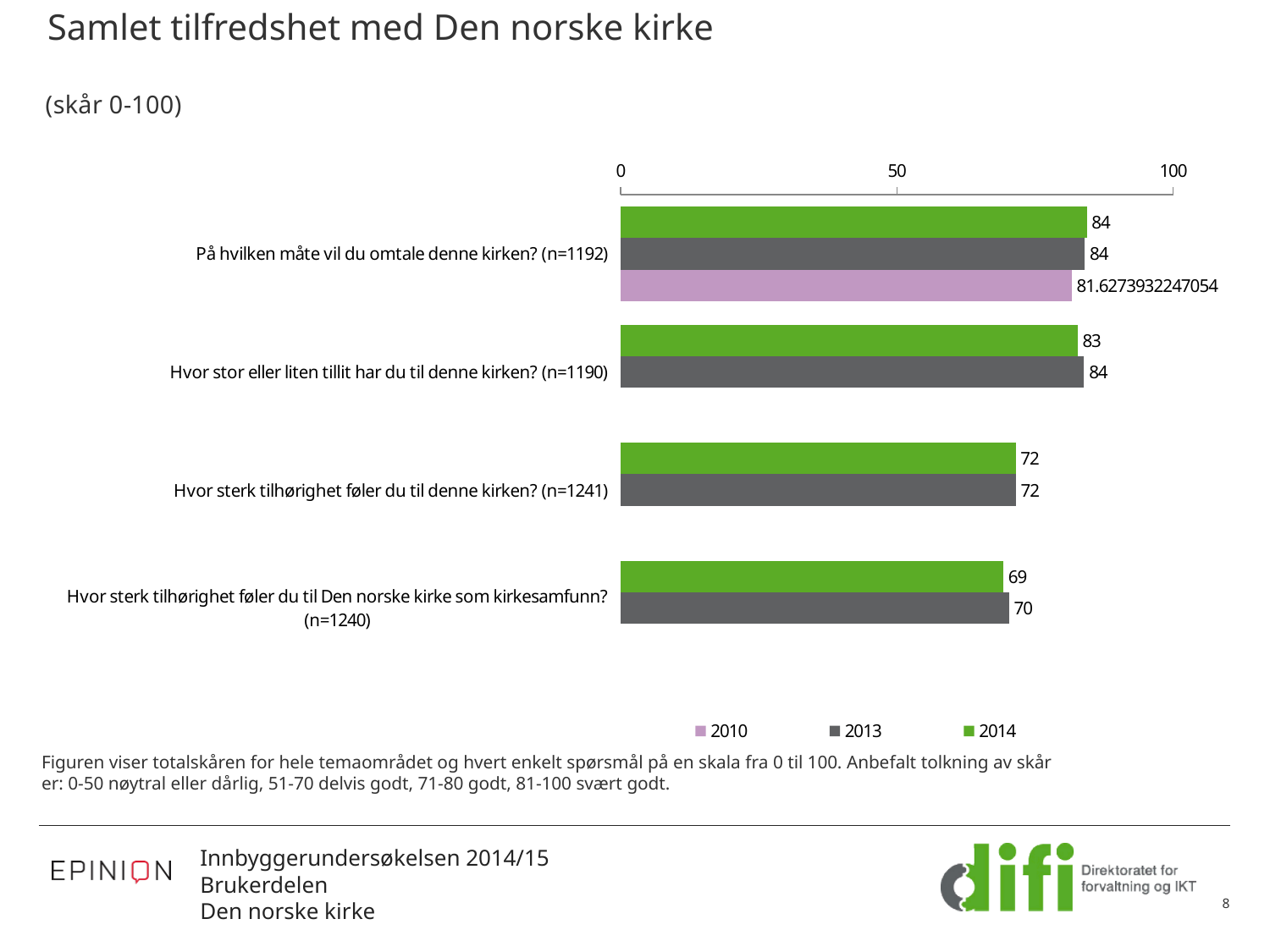
How many series does the legend list? 3 What is the 2010 value for "På hvilken måte vil du omtale denne kirken? (n=1192)"? 81.6273932247054 How many question categories are shown in the chart? 4 What is the 2013 value for "Hvor stor eller liten tillit har du til denne kirken? (n=1190)"? 84 Which is larger for "Hvor stor eller liten tillit har du til denne kirken? (n=1190)": the 2013 value or the 2014 value? 2013 What is the 2014 value for "Hvor sterk tilhørighet føler du til Den norske kirke som kirkesamfunn? (n=1240)"? 69 What kind of chart is shown on the slide? bar chart What is the difference between the 2013 and 2014 values for "Hvor sterk tilhørighet føler du til Den norske kirke som kirkesamfunn? (n=1240)"? 1 Which category has the lowest 2014 value? Hvor sterk tilhørighet føler du til Den norske kirke som kirkesamfunn? (n=1240) Which year is shown in green in the legend? 2014 Is the 2014 value for "Hvor sterk tilhørighet føler du til denne kirken? (n=1241)" greater or less than 50? greater What is the 2014 value for "På hvilken måte vil du omtale denne kirken? (n=1192)"? 84